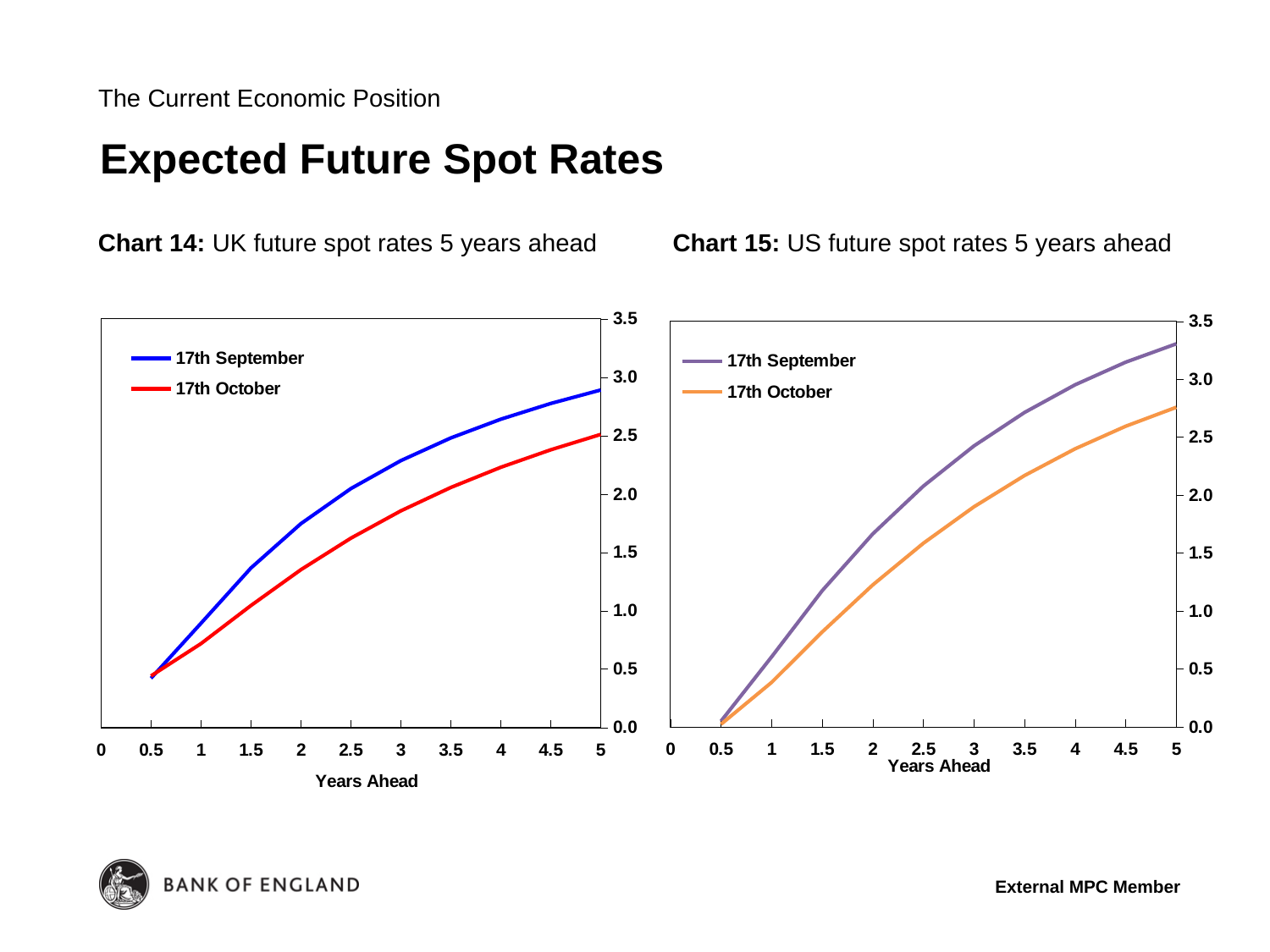
In Chart 15: US future spot rates 5 years ahead, which series is higher at 3 years ahead, 17th September or 17th October? 17th September In Chart 15: US future spot rates 5 years ahead, do the values for 17th October rise or fall as years ahead increase? rise In Chart 15: US future spot rates 5 years ahead, what colour is the 17th October line? orange In Chart 14: UK future spot rates 5 years ahead, is the value for 17th October at 5 years ahead greater or less than 2.0? greater What kind of chart is Chart 14: UK future spot rates 5 years ahead? line chart In Chart 15: US future spot rates 5 years ahead, is the value for 17th September at 5 years ahead greater or less than 3.0? greater In Chart 15: US future spot rates 5 years ahead, is the value for 17th October at 2 years ahead greater or less than 1.0? greater In Chart 14: UK future spot rates 5 years ahead, do the values for 17th September rise or fall as years ahead increase? rise In Chart 14: UK future spot rates 5 years ahead, which series is higher at 5 years ahead, 17th September or 17th October? 17th September What is the x-axis label of Chart 14: UK future spot rates 5 years ahead? Years Ahead How many series does the legend of Chart 15: US future spot rates 5 years ahead list? 2